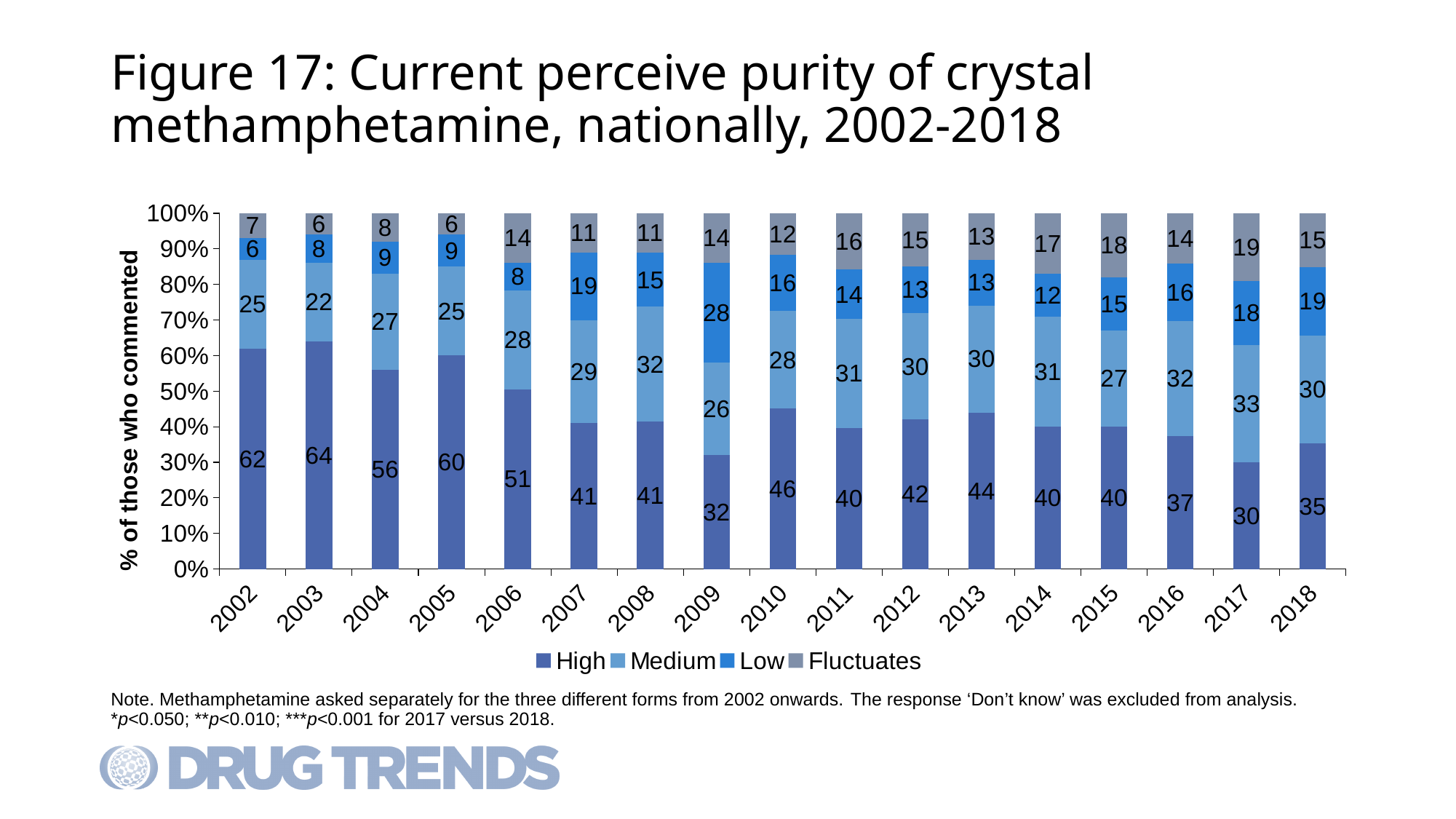
Does the High category generally rise or fall from 2002 to 2018? Fall What is the value for Fluctuates in 2014? 17 How many series does the legend list? 4 What is the value for the Low category in 2009? 28 In which year is the High category at its highest? 2003 In which year is the Low category at its highest? 2009 In which year is the High category at its lowest? 2017 What is the difference between the High values for 2018 and 2017? 5 What percentage of those who commented rated the purity of crystal methamphetamine as High in 2002? 62 Which is larger, the Medium value in 2017 or the Medium value in 2018? 2017 How many years are shown on the x axis? 17 What kind of chart is shown on the slide? Stacked bar chart